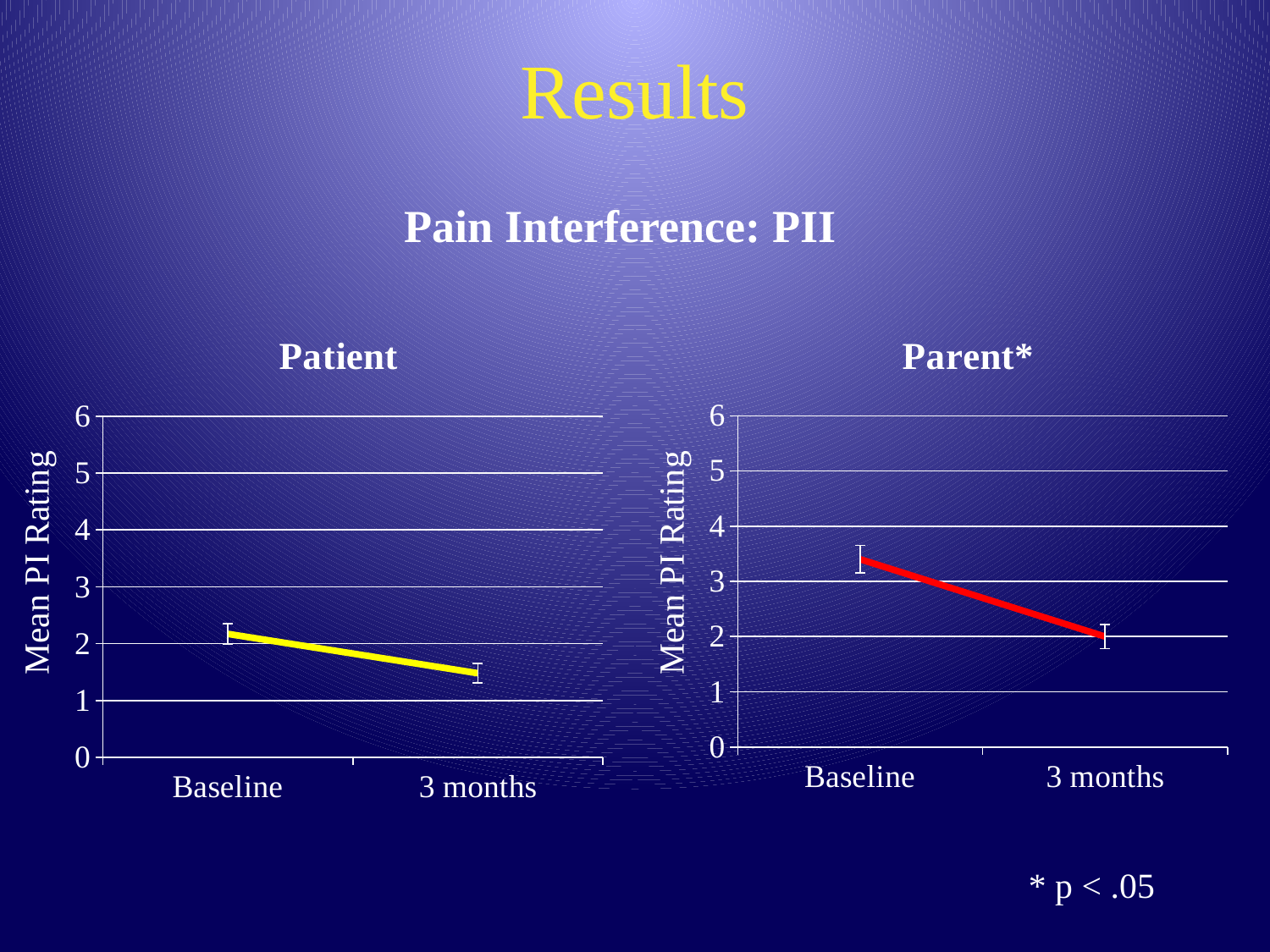
In the Parent* chart, is the value at Baseline greater or less than 3? greater What kind of chart is the Patient chart? line chart What colour is the line in the Parent* chart? red In the Patient chart, does the mean PI rating rise or fall from Baseline to 3 months? fall What is the y-axis label of the Patient chart? Mean PI Rating In the Patient chart, is the value at 3 months greater or less than 1? greater In the Parent* chart, does the mean PI rating rise or fall from Baseline to 3 months? fall In the Parent* chart, is the value at Baseline greater or less than 4? less In the Patient chart, which time point has the higher mean PI rating, Baseline or 3 months? Baseline How many time points are plotted on the x axis of the Parent* chart? 2